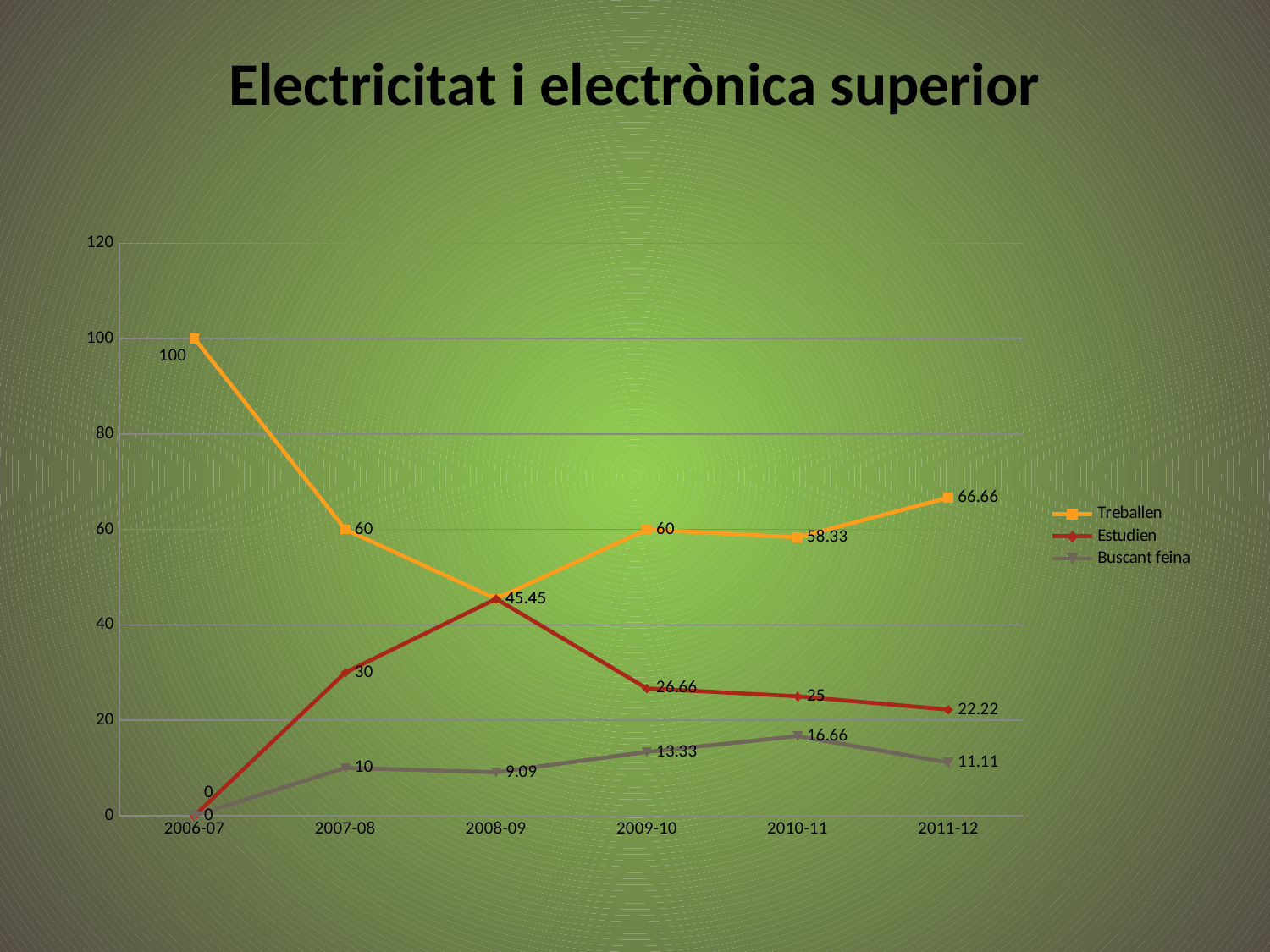
What is the value for Treballen in 2006-07? 100 What is the value for Treballen in 2011-12? 66.66 What is the value for Buscant feina in 2010-11? 16.66 What is the value for Estudien in 2007-08? 30 How many series does the legend list? 3 What type of chart is shown on the slide? line chart What is the difference between the Treballen value in 2006-07 and in 2007-08? 40 Does the Estudien value rise or fall from 2008-09 to 2011-12? fall How many academic years are shown on the x axis? 6 In which year is the Buscant feina value highest? 2010-11 Which is larger in 2009-10, Treballen or Estudien? Treballen In which year is the Treballen value lowest? 2008-09